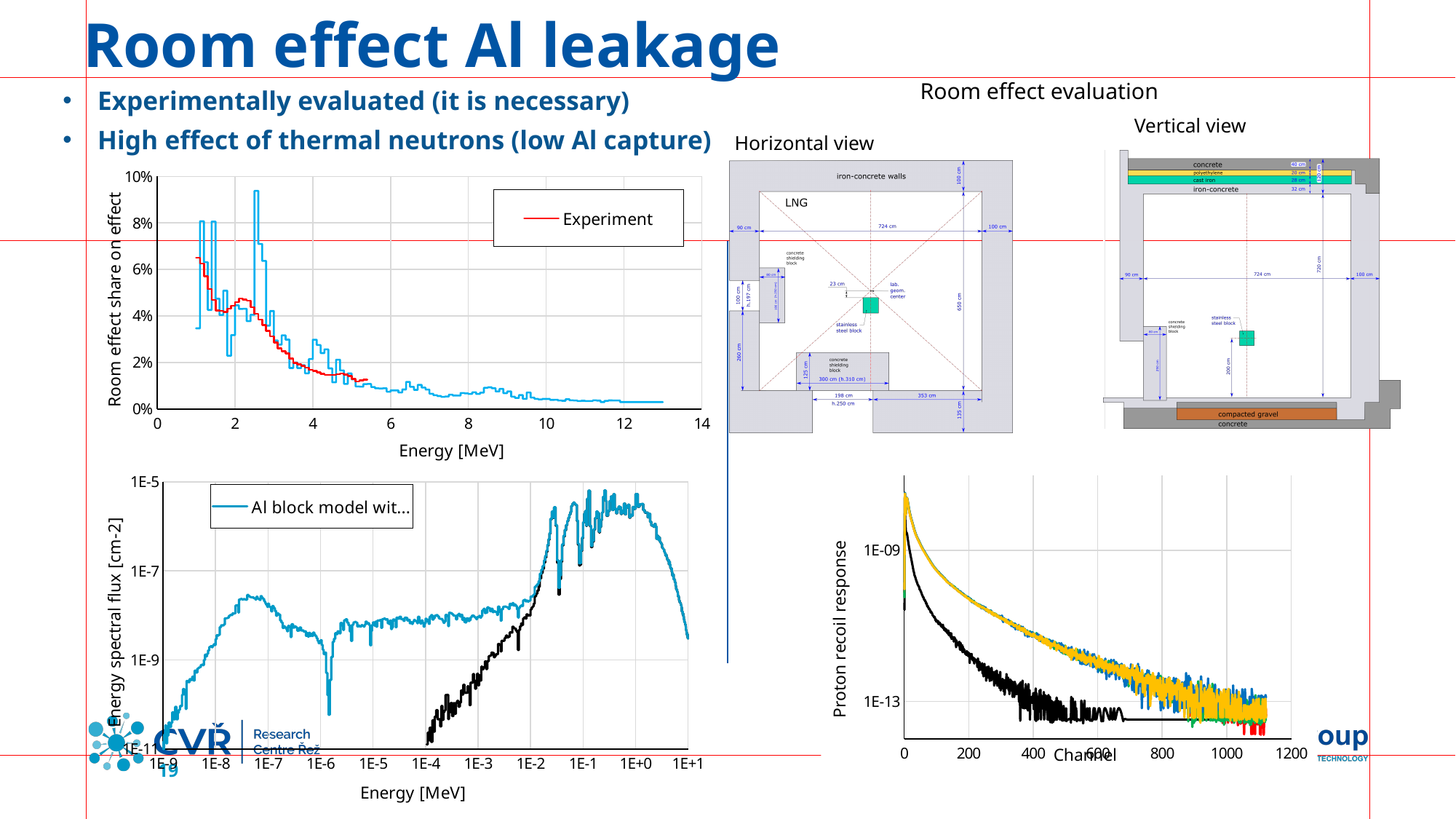
What is the y-axis label of the bottom-left chart? Energy spectral flux [cm-2] In the top-left chart (Room effect share on effect), do the values generally rise or fall as energy increases from 2 to 12 MeV? fall In the top-left chart (Room effect share on effect), is the value of the blue line at 10 MeV greater or less than 2%? less In the bottom-right chart (Proton recoil response), do the values rise or fall as the channel number increases? fall What kind of chart is the top-left chart with the y axis 'Room effect share on effect'? line chart In the top-left chart (Room effect share on effect), what entry does the legend list? Experiment In the top-left chart (Room effect share on effect), what is the label of the x axis? Energy [MeV] What kind of chart is the bottom-left chart with the y axis 'Energy spectral flux [cm-2]'? line chart In the bottom-right chart (Proton recoil response), is the value of the black line at channel 200 greater or less than 1E-09? less In the top-left chart (Room effect share on effect), is the highest peak of the blue line greater or less than 8%? greater